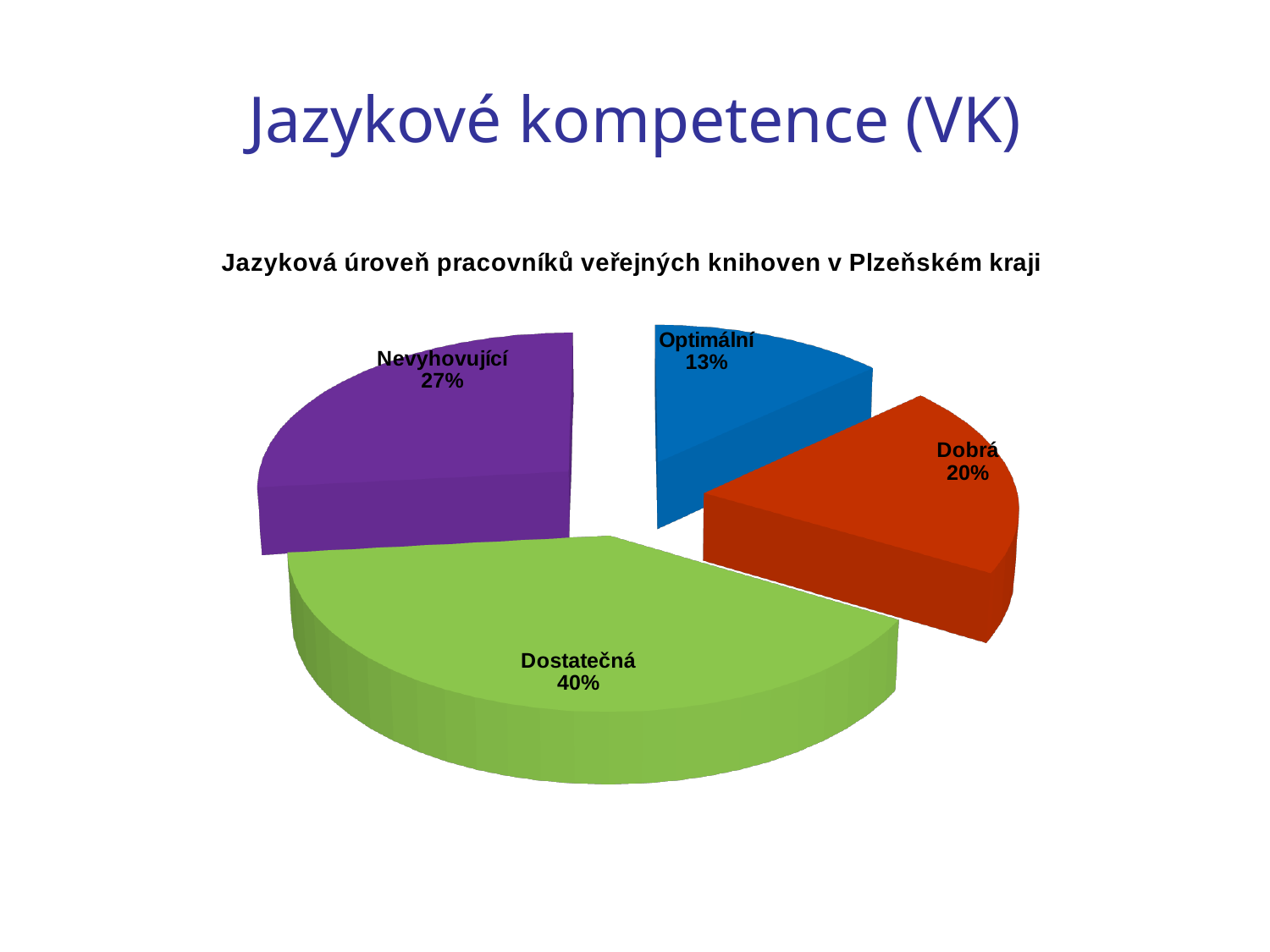
What is the difference in percentage points between Dostatečná and Nevyhovující? 13 Which is larger, the share for Nevyhovující or the share for Dobrá? Nevyhovující What kind of chart is shown on the slide? Pie chart What is the value shown for Dobrá? 20% How many slices does the pie chart have? 4 Which category has the smallest share of the pie? Optimální What share of the pie does the Dostatečná slice represent? 40% Which category has the largest share of the pie? Dostatečná What is the difference in percentage points between Dobrá and Optimální? 7 What is the value shown for Optimální? 13% What is the title of the chart? Jazyková úroveň pracovníků veřejných knihoven v Plzeňském kraji What is the value shown for Nevyhovující? 27%